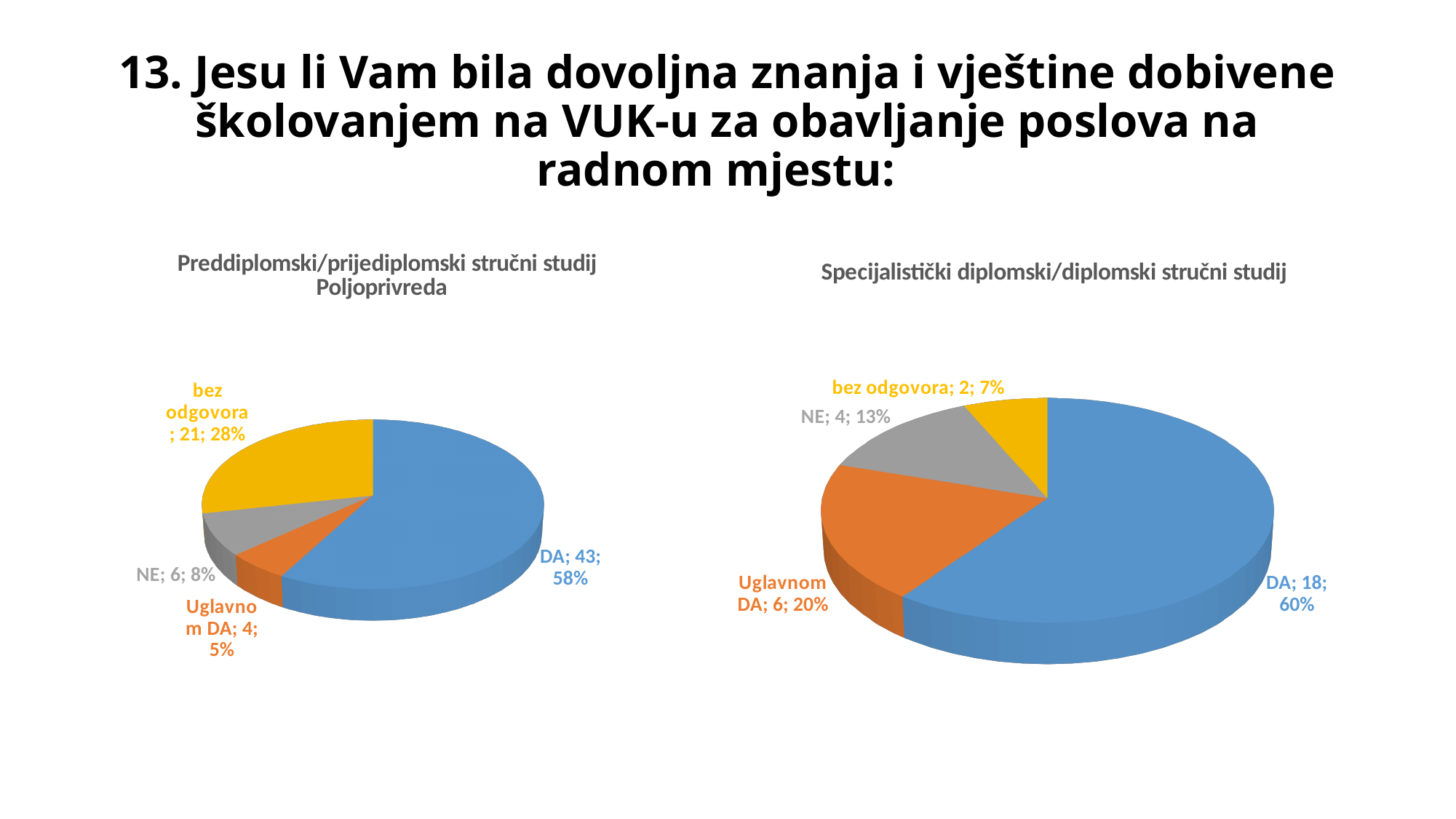
What kind of chart is the right chart (Specijalistički diplomski/diplomski stručni studij)? Pie chart In the right chart (Specijalistički diplomski/diplomski stručni studij), what is the value for NE? 4 In the right chart (Specijalistički diplomski/diplomski stručni studij), which category has the highest value? DA In the left chart (Preddiplomski/prijediplomski stručni studij Poljoprivreda), what is the value for DA? 43 In the right chart (Specijalistički diplomski/diplomski stručni studij), what share of the pie is DA? 60% In the left chart (Preddiplomski/prijediplomski stručni studij Poljoprivreda), what share of the pie is bez odgovora? 28% In the right chart (Specijalistički diplomski/diplomski stručni studij), which is larger, Uglavnom DA or NE? Uglavnom DA In the left chart (Preddiplomski/prijediplomski stručni studij Poljoprivreda), which category has the lowest value? Uglavnom DA In the left chart (Preddiplomski/prijediplomski stručni studij Poljoprivreda), what colour is the DA slice? Blue In the left chart (Preddiplomski/prijediplomski stručni studij Poljoprivreda), how many slices does the pie have? 4 In the left chart (Preddiplomski/prijediplomski stručni studij Poljoprivreda), what is the difference between the values for DA and bez odgovora? 22 In the right chart (Specijalistički diplomski/diplomski stručni studij), what is the total of all slice values? 30